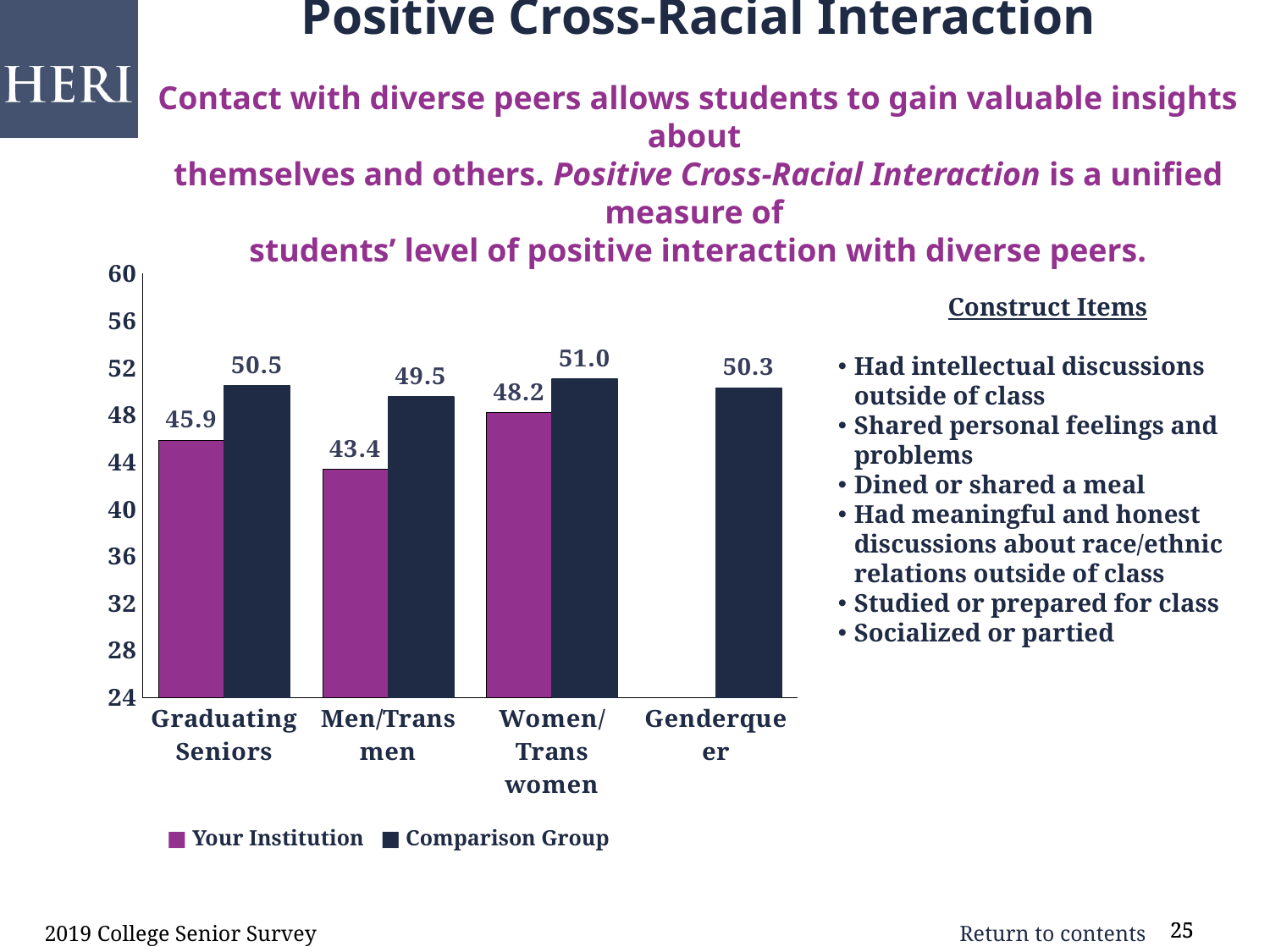
What is the Your Institution value for Women/Trans women? 48.2 What is the Comparison Group value for Men/Trans men? 49.5 What is the difference between the Comparison Group and Your Institution values for Men/Trans men? 6.1 What is the Your Institution value for Graduating Seniors? 45.9 Which category has the highest Comparison Group value? Women/Trans women How many series does the legend list? 2 What kind of chart is shown on the slide? bar chart Which is larger for Graduating Seniors: the Your Institution value or the Comparison Group value? Comparison Group What is the Comparison Group value for Genderqueer? 50.3 Is the Your Institution value for Men/Trans men greater or less than 44? less Which category has the lowest Your Institution value? Men/Trans men How many categories are shown on the x axis? 4